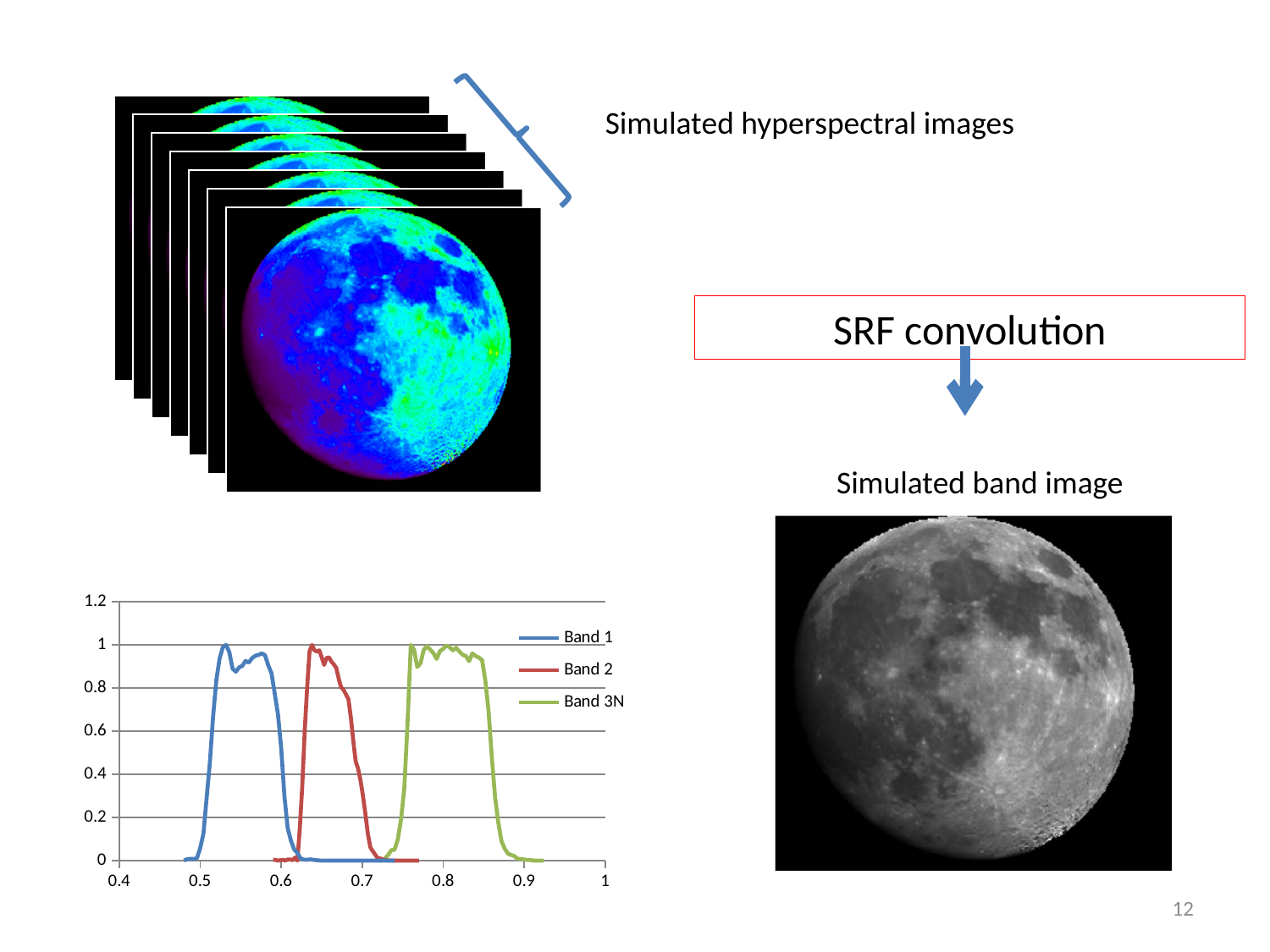
What kind of chart is shown at the bottom left of the slide? line chart In the line chart, is the value of Band 1 at x = 0.7 greater or less than 0.2? less In the line chart, at x = 0.55, which series has the larger value, Band 1 or Band 2? Band 1 What are the names of the series in the line chart's legend? Band 1, Band 2, Band 3N In the line chart, is the value of Band 1 at x = 0.55 greater or less than 0.8? greater In the line chart, which series is located furthest to the right along the x axis? Band 3N How many series does the legend of the line chart list? 3 In the line chart, does the Band 3N curve rise or fall between x = 0.85 and x = 0.9? fall In the line chart, which colour is used for the Band 2 series? red In the line chart, is the value of Band 3N at x = 0.8 greater or less than 0.8? greater